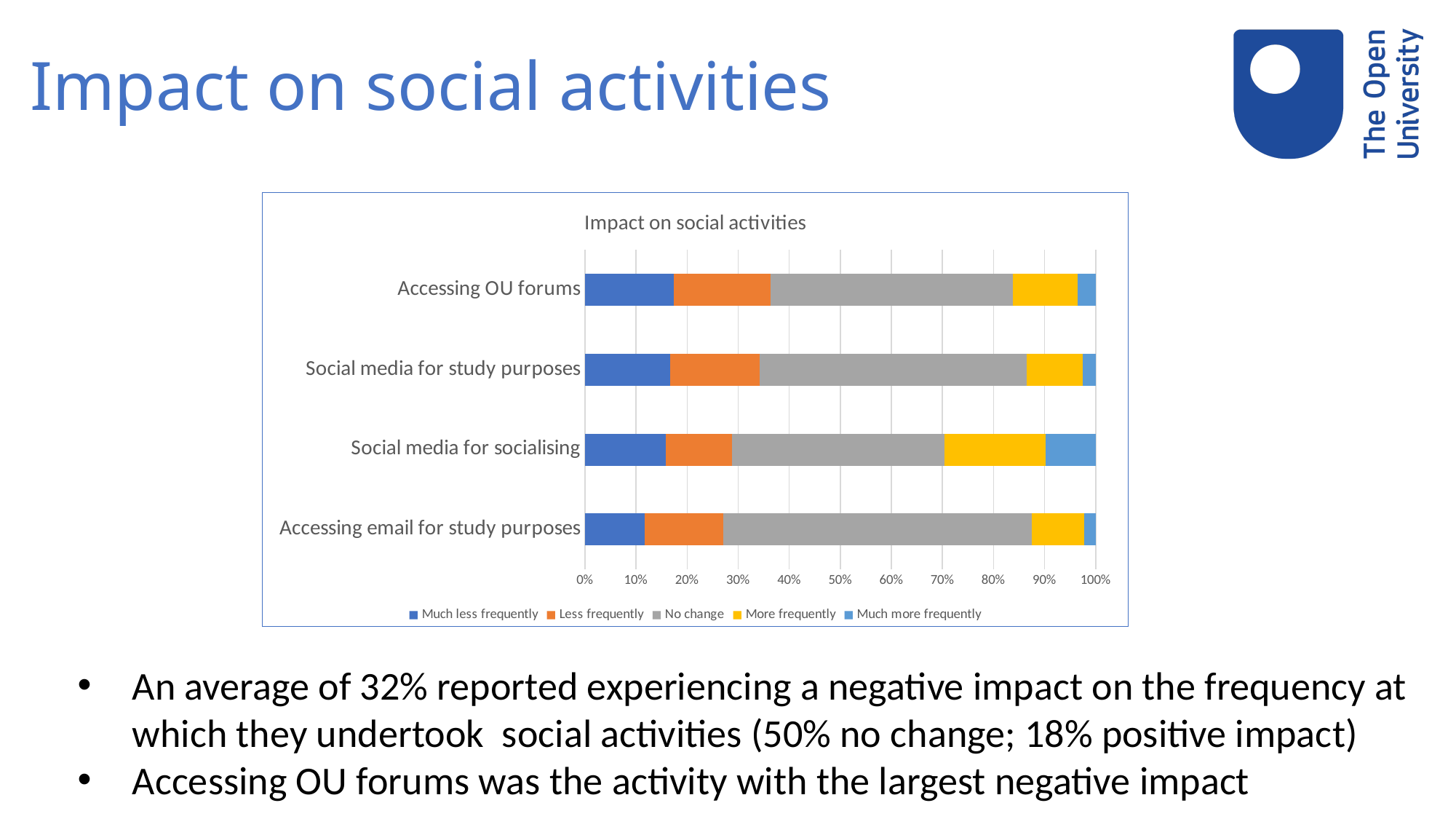
What kind of chart is shown on the slide? Stacked bar chart Which activity has the smallest 'Much less frequently' segment? Accessing email for study purposes How many activities (categories) are plotted in the chart? 4 Which colour represents the 'No change' series in the chart? Grey Is the 'No change' share for Accessing email for study purposes greater or less than 50%? greater Which activity has the smallest 'No change' segment? Social media for socialising What is the title of the chart? Impact on social activities Is the 'No change' share for Social media for socialising greater or less than 50%? less Which activity has the largest 'Much more frequently' segment? Social media for socialising Which activity has the largest 'No change' segment? Accessing email for study purposes How many series does the chart legend list? 5 Is the 'Much less frequently' segment larger for Accessing OU forums or for Accessing email for study purposes? Accessing OU forums